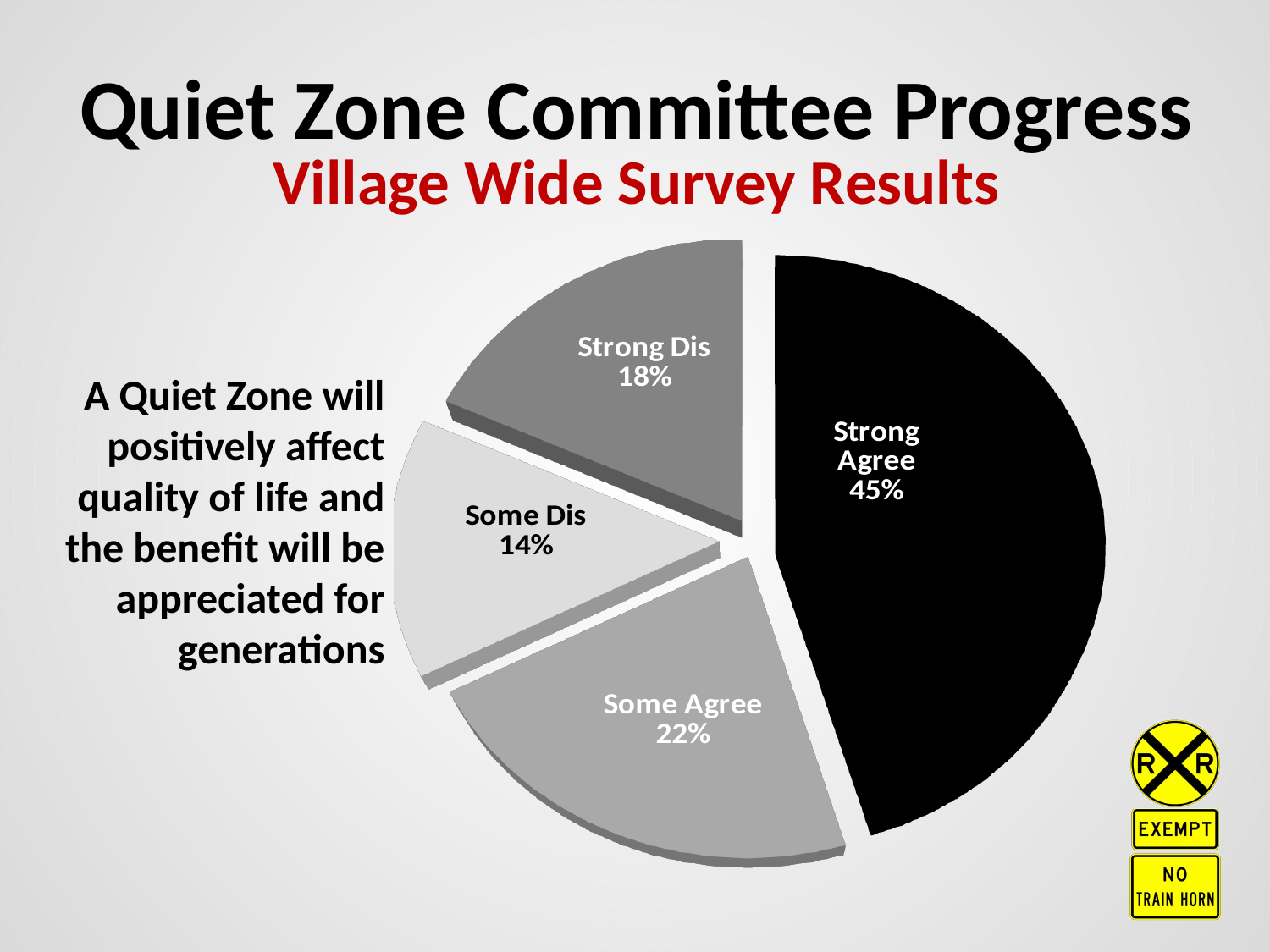
What percentage of respondents chose Some Dis? 14% What is the difference in percentage points between Strong Agree and Some Agree? 23 What kind of chart is shown on the slide? pie chart Which is larger, the Strong Dis share or the Some Dis share? Strong Dis How many slices does the pie chart have? 4 Which slice of the pie is coloured black? Strong Agree Which response category has the smallest share of the pie? Some Dis What percentage of respondents chose Strong Dis? 18% What is the combined share of Strong Agree and Some Agree? 67% What percentage of respondents chose Some Agree? 22% What percentage of respondents chose Strong Agree? 45% Which response category has the largest share of the pie? Strong Agree